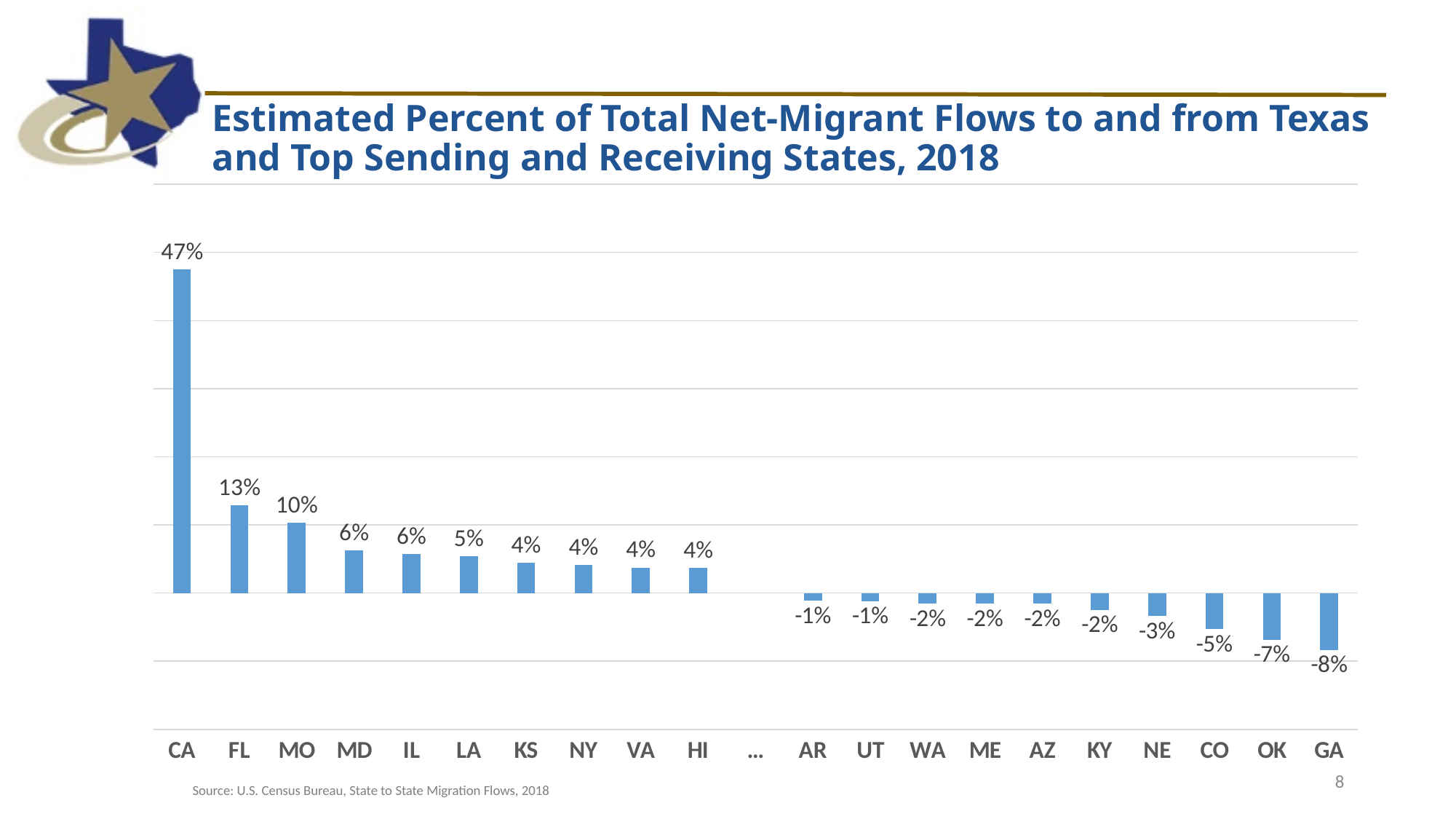
What is the title of the chart? Estimated Percent of Total Net-Migrant Flows to and from Texas and Top Sending and Receiving States, 2018 What is the difference between the values for MO and MD? 4% Which state has the lowest value? GA What kind of chart is shown on the slide? Bar chart What is the value for NE? -3% How many states are shown with positive values? 10 Which state has the highest value? CA What is the value for FL? 13% Which is larger, the value for FL or the value for MO? FL What is the value for CA? 47% What is the value for GA? -8% What is the difference between the values for CA and FL? 34%